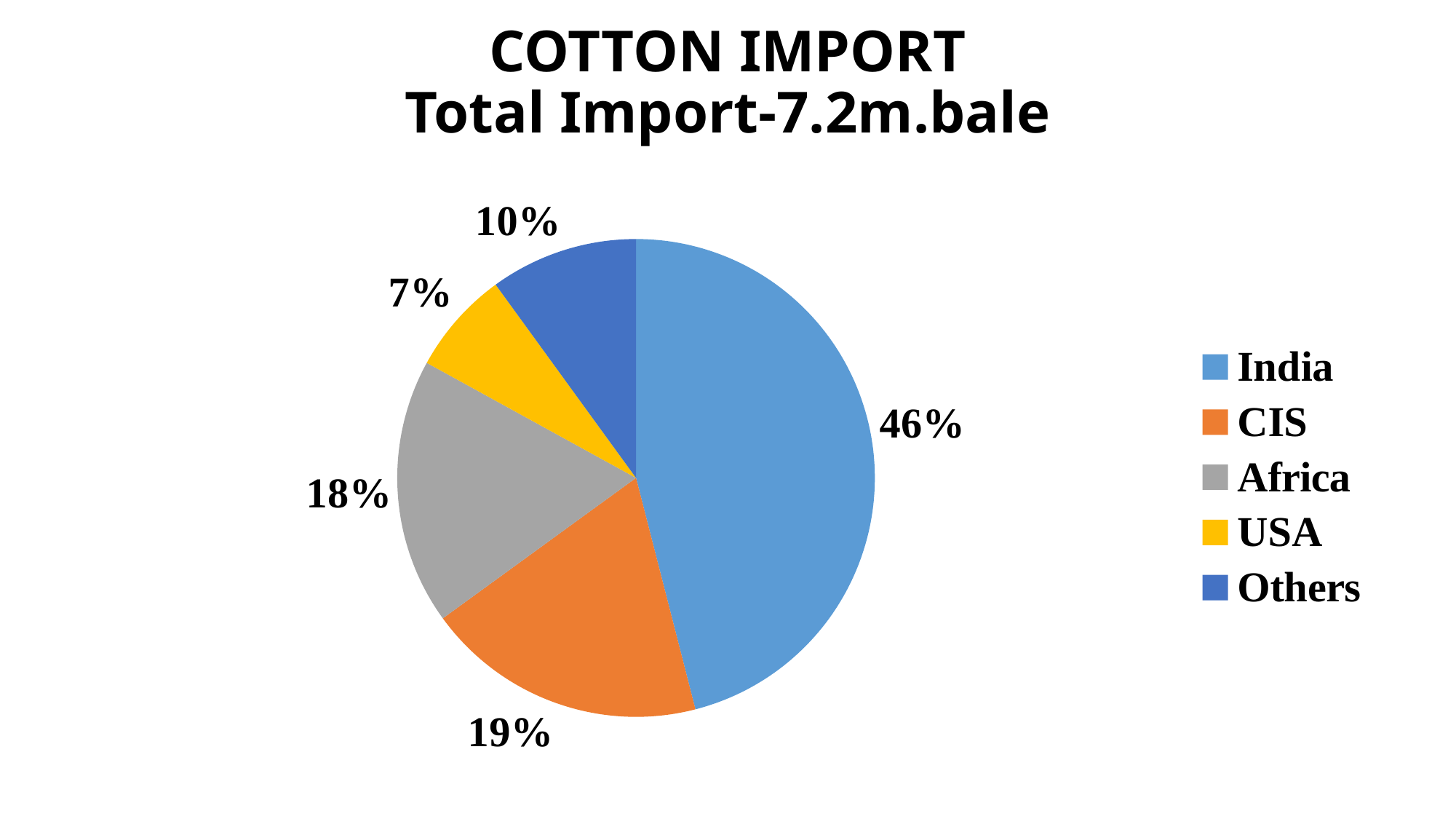
How many slices does the pie chart have? 5 What is the difference in percentage points between India's share and CIS's share? 27 What share does Africa hold in the cotton import pie chart? 18% What kind of chart is shown on the slide? Pie chart Which has a larger share, Others or USA? Others What total import volume is stated in the chart title? 7.2m.bale Which source has the smallest share of cotton imports? USA Which source has the largest share of cotton imports? India What share of cotton imports comes from India? 46% What percentage of the pie is CIS? 19% What share is labelled for Others? 10% What percentage of cotton imports comes from the USA? 7%